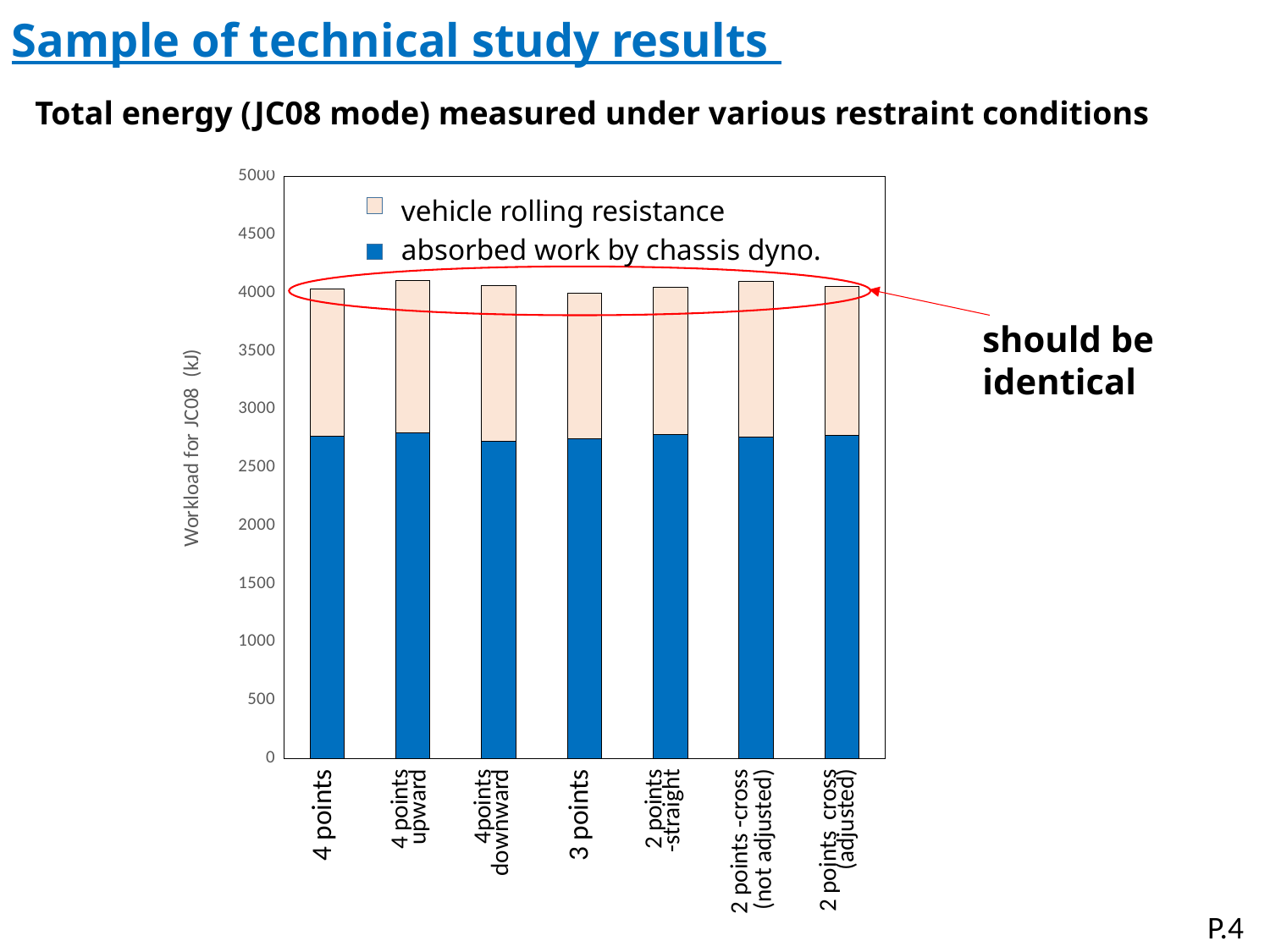
Is the absorbed work by chassis dyno for "4 points upward" greater or less than 2000? greater How many series does the legend list? 2 What is the label of the y axis? Workload for JC08 (kJ) Is the total workload for "2 points -cross (not adjusted)" greater or less than 3000? greater What kind of chart is shown on the slide? stacked bar chart Is the total workload for "4 points" greater or less than 3500? greater How many restraint conditions (categories) are plotted along the x axis? 7 What are the two series named in the legend? vehicle rolling resistance; absorbed work by chassis dyno.